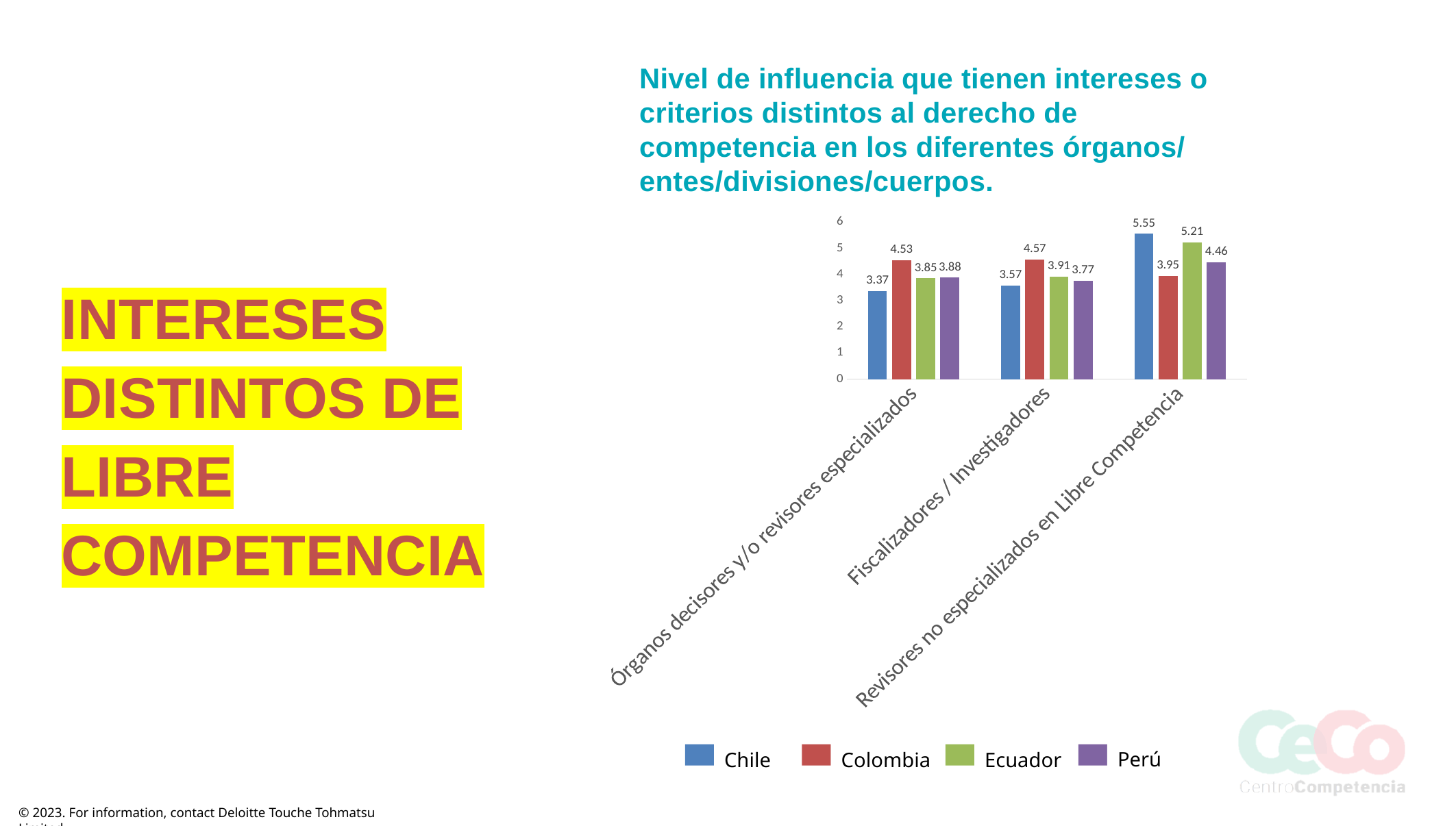
What is the value for Chile in the 'Revisores no especializados en Libre Competencia' category? 5.55 Which country has the highest value in the 'Órganos decisores y/o revisores especializados' category? Colombia How many categories are shown on the x axis of the chart? 3 Which colour represents Colombia in the chart legend? Red What kind of chart is shown on the slide? Bar chart What is the value for Colombia in the 'Fiscalizadores / Investigadores' category? 4.57 How many series does the legend list? 4 What is the value for Perú in the 'Revisores no especializados en Libre Competencia' category? 4.46 Which country has the lowest value in the 'Fiscalizadores / Investigadores' category? Chile What is the difference between Chile's and Colombia's values in the 'Revisores no especializados en Libre Competencia' category? 1.60 What is the value for Ecuador in the 'Órganos decisores y/o revisores especializados' category? 3.85 Which is larger: Ecuador's value or Perú's value in the 'Fiscalizadores / Investigadores' category? Ecuador